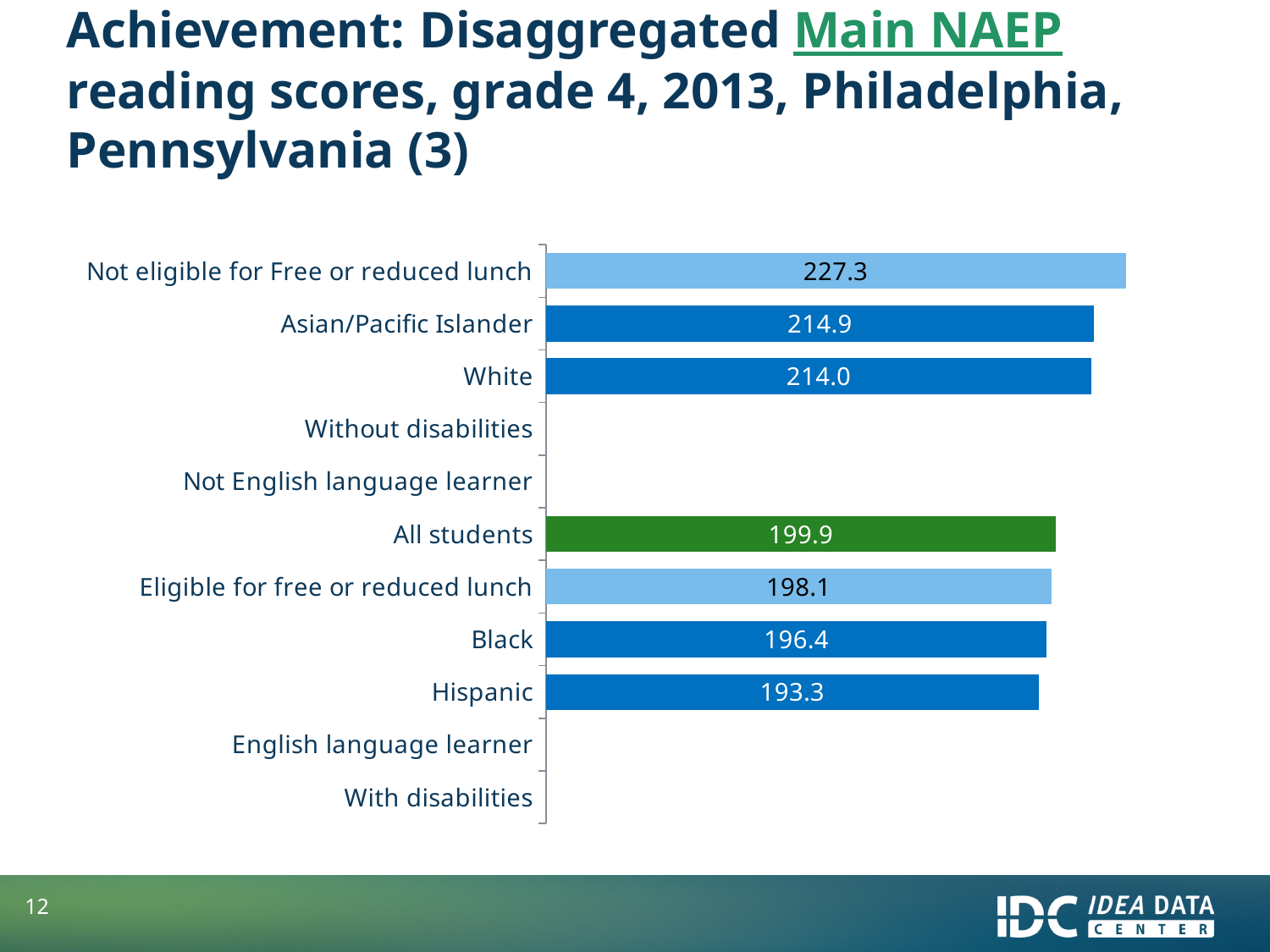
What is the reading score shown for Black students? 196.4 What is the reading score shown for All students? 199.9 What is the difference between the All students score and the Hispanic score? 6.6 Which category has the highest reading score on the chart? Not eligible for Free or reduced lunch What colour is the bar for All students? Green What type of chart is shown on the slide? Bar chart What is the reading score shown for Hispanic students? 193.3 How many categories are listed on the vertical axis of the chart? 11 Which category with a plotted bar has the lowest reading score? Hispanic What is the difference between the scores for students not eligible for free or reduced lunch and students eligible for free or reduced lunch? 29.2 Which is larger, the score for Asian/Pacific Islander students or the score for White students? Asian/Pacific Islander What is the Main NAEP grade 4 reading score for students not eligible for free or reduced lunch? 227.3